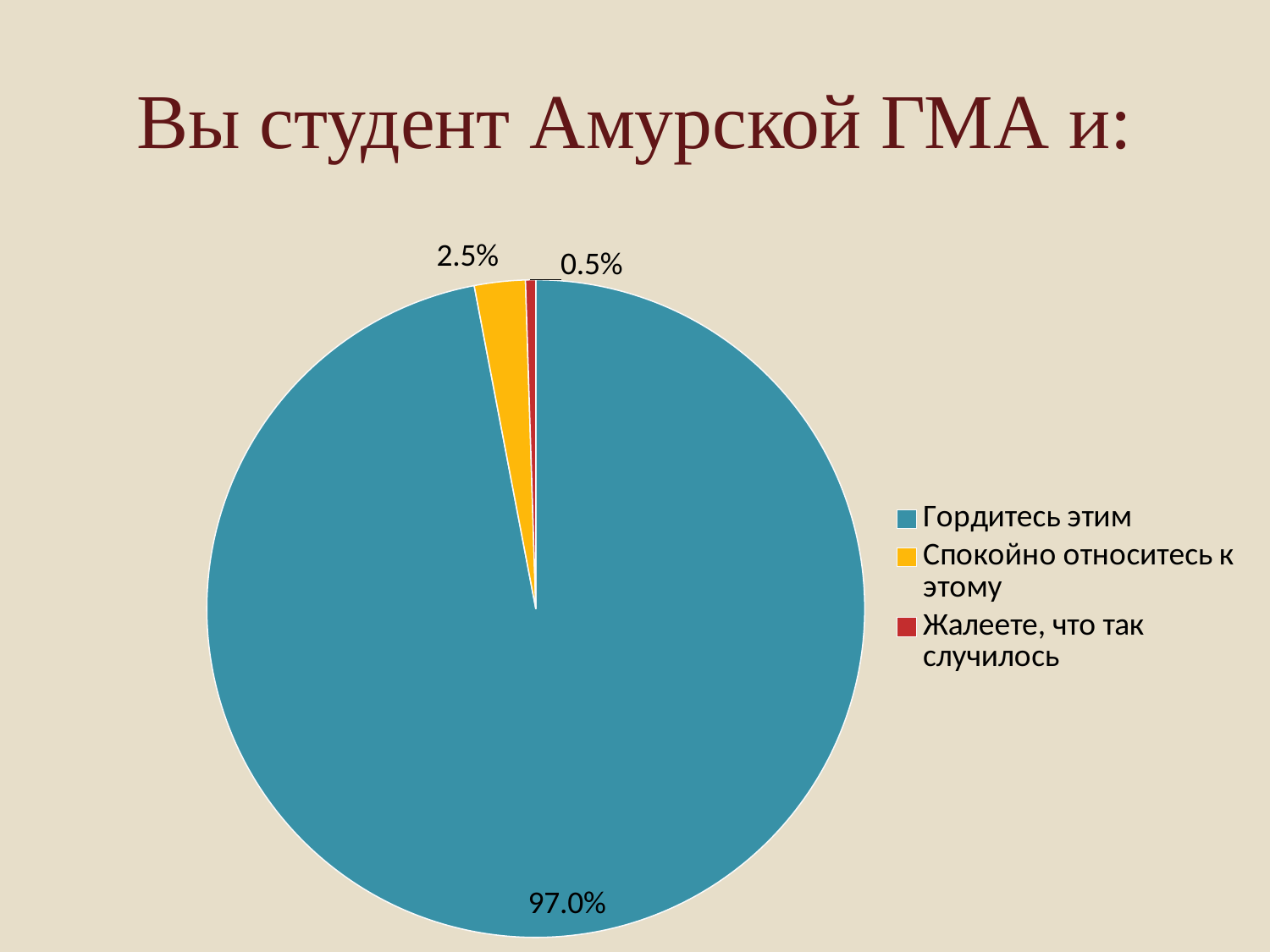
How many categories does the pie chart have? 3 What is the difference between the shares for "Спокойно относитесь к этому" and "Жалеете, что так случилось"? 2.0% What percentage of respondents chose "Спокойно относитесь к этому"? 2.5% Which category has the largest share of the pie? Гордитесь этим What colour is the slice for "Спокойно относитесь к этому"? yellow What kind of chart is shown on the slide? pie chart What percentage of respondents chose "Гордитесь этим"? 97.0% Which category has the smallest share of the pie? Жалеете, что так случилось Which is larger: the share for "Спокойно относитесь к этому" or for "Жалеете, что так случилось"? Спокойно относитесь к этому What percentage of respondents chose "Жалеете, что так случилось"? 0.5% What is the title of the slide? Вы студент Амурской ГМА и: What is the difference between the shares for "Гордитесь этим" and "Спокойно относитесь к этому"? 94.5%